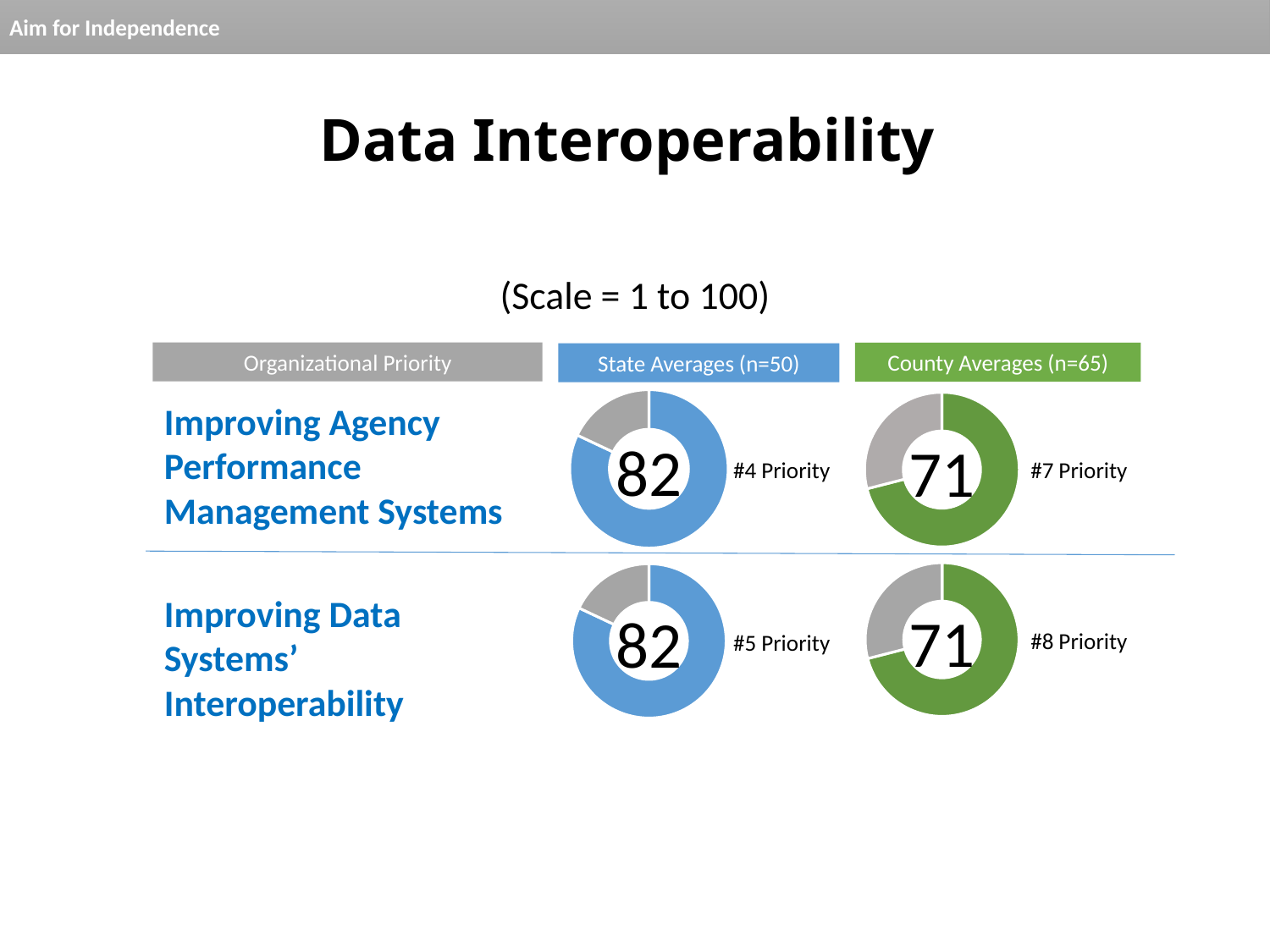
What is the difference between the State Average and the County Average for Improving Agency Performance Management Systems? 11 What colour are the State Averages doughnut charts? Blue How many organizational priorities are shown on the slide? 2 What is the State Average for Improving Agency Performance Management Systems? 82 What is the County Average for Improving Agency Performance Management Systems? 71 What is the sample size (n) for the County Averages? 65 What priority rank does Improving Agency Performance Management Systems have among State respondents? #4 Priority What is the State Average for Improving Data Systems' Interoperability? 82 Which is larger for Improving Data Systems' Interoperability, the State Average or the County Average? State Average What priority rank does Improving Data Systems' Interoperability have among County respondents? #8 Priority What kind of chart is used to display the averages on this slide? Doughnut chart What is the County Average for Improving Data Systems' Interoperability? 71